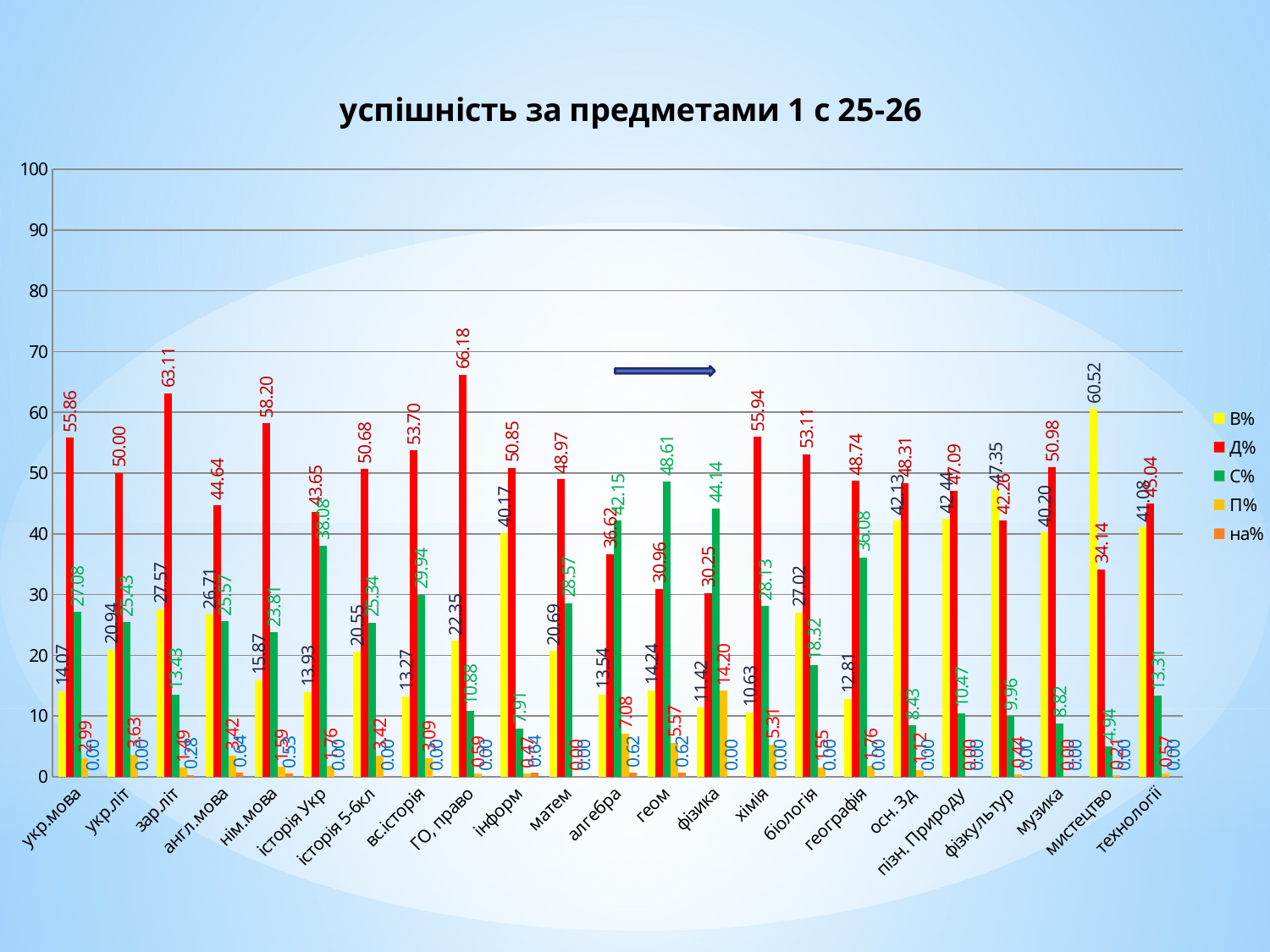
How many subject categories are shown on the x axis? 23 What is the П% value for фізика? 14.20 What is the Д% value for ГО, право? 66.18 What is the В% value for мистецтво? 60.52 What kind of chart is shown on the slide? bar chart Which is larger for фізкультур: the В% value or the Д% value? В% What is the С% value for геом? 48.61 What is the difference between the Д% values for зар.літ and укр.літ? 13.11 Which subject has the highest Д% value? ГО, право What is the title of the chart? успішність за предметами 1 с 25-26 Which subject has the lowest Д% value? фізика How many series does the legend list? 5